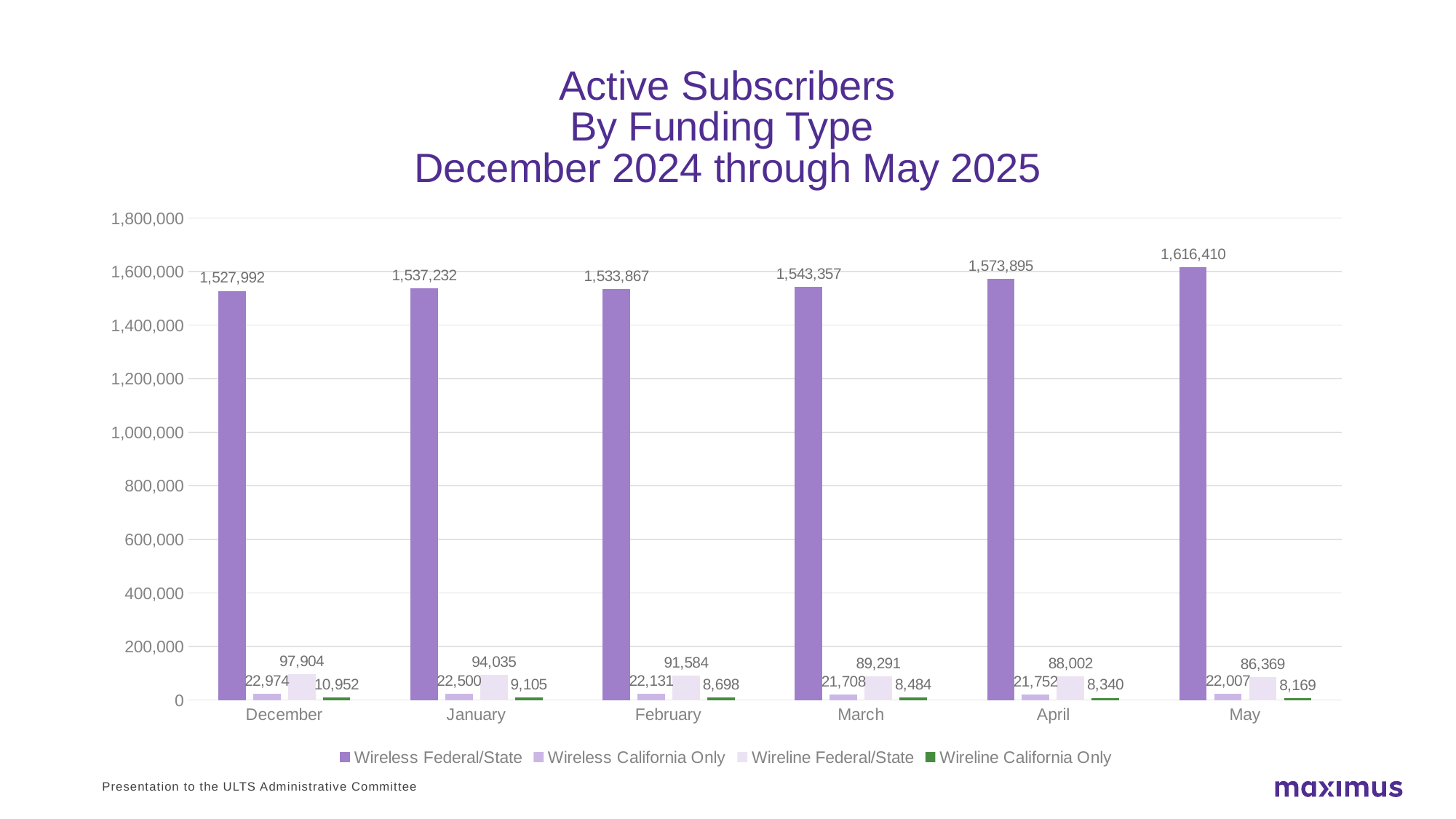
In which month is Wireless Federal/State highest? May In which month is Wireline California Only lowest? May What is the difference between the Wireline Federal/State values for December and May? 11,535 What is the value for Wireline California Only in February? 8,698 Which is larger, Wireline Federal/State in January or Wireline Federal/State in April? January What is the value for Wireless California Only in March? 21,708 What is the value for Wireline Federal/State in December? 97,904 How many series does the legend list? 4 What is the value for Wireless Federal/State in May? 1,616,410 What is the difference between the Wireless Federal/State values for May and December? 88,418 How many months are shown on the x axis? 6 Does the Wireline Federal/State series rise or fall from December to May? fall